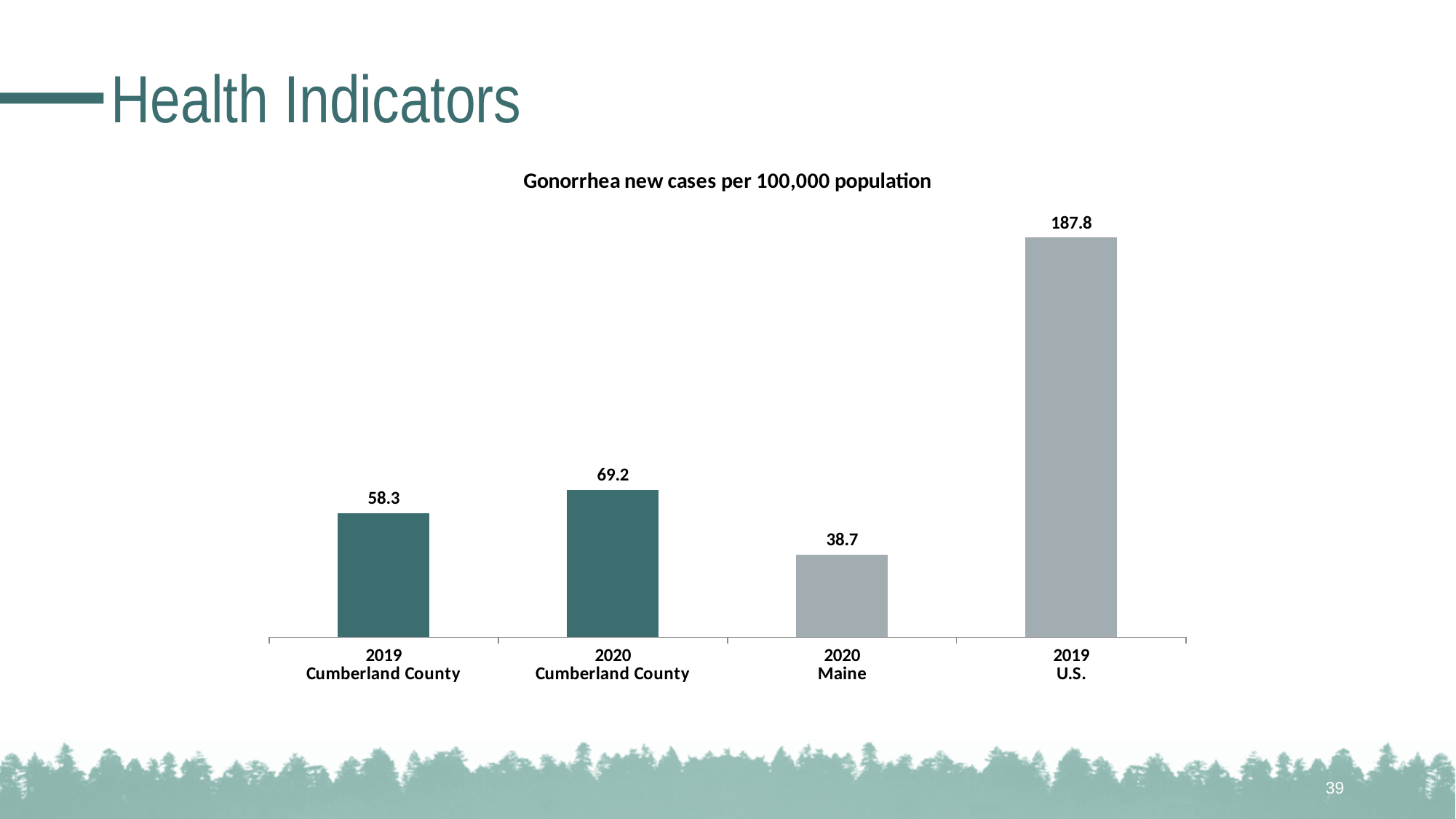
What kind of chart is shown on the slide? Bar chart What is the value for 2020 Maine? 38.7 Which is larger, the value for 2020 Cumberland County or the value for 2020 Maine? 2020 Cumberland County What is the title of the chart? Gonorrhea new cases per 100,000 population What is the difference between the 2020 Cumberland County value and the 2019 Cumberland County value? 10.9 How many categories are shown in the chart? 4 What is the value for 2019 U.S.? 187.8 What is the value for 2020 Cumberland County? 69.2 What is the value for 2019 Cumberland County? 58.3 Which category has the highest value? 2019 U.S. What is the difference between the 2019 U.S. value and the 2020 Maine value? 149.1 Which category has the lowest value? 2020 Maine